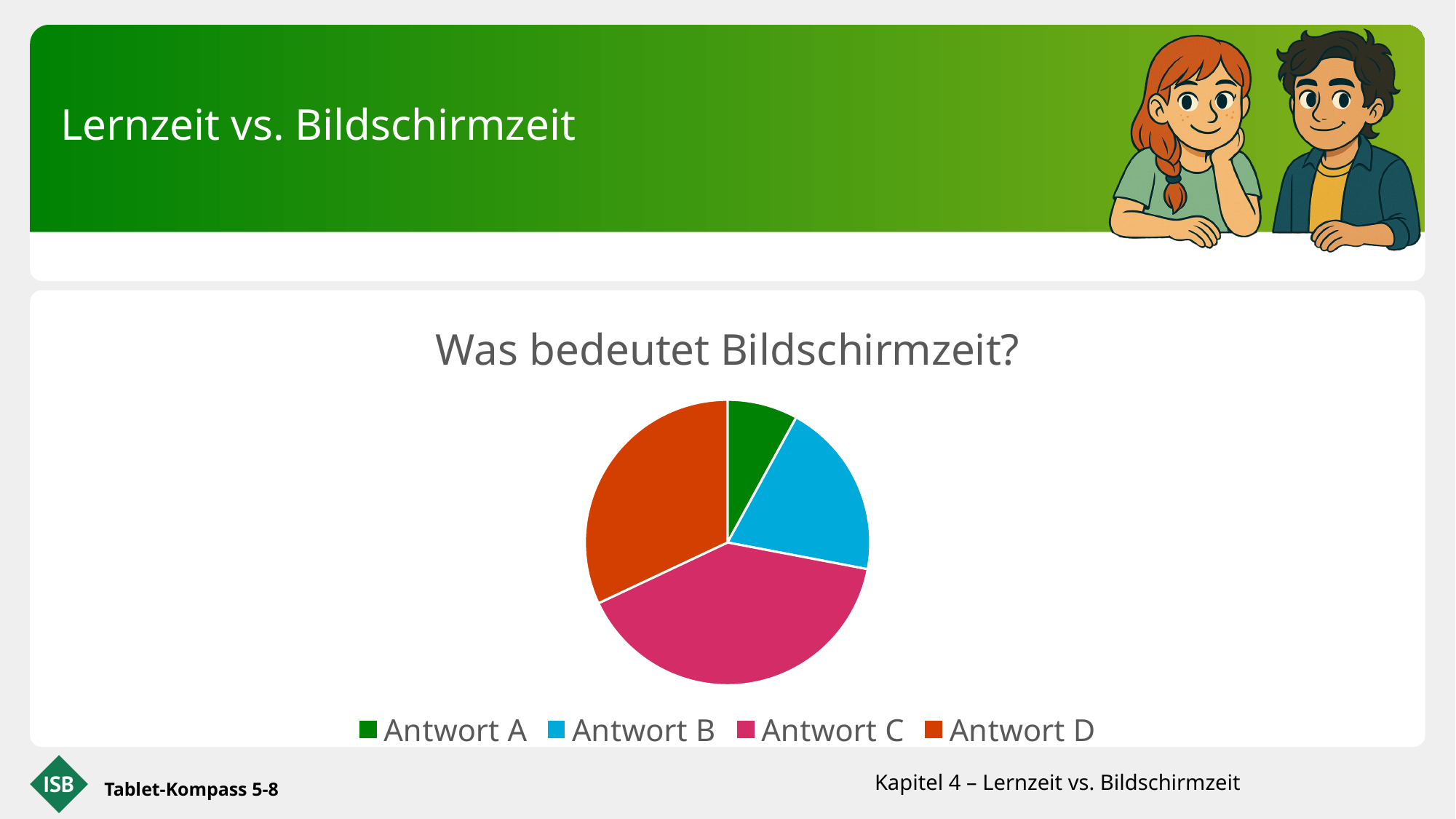
How many entries does the legend list? 4 Which slice is larger, Antwort A or Antwort D? Antwort D Which slice is larger, Antwort C or Antwort D? Antwort C Which slice is larger, Antwort B or Antwort D? Antwort D Which answer has the smallest slice of the pie? Antwort A What kind of chart is shown on the slide? Pie chart How many slices does the pie chart have? 4 What is the title of the chart? Was bedeutet Bildschirmzeit? Which colour represents Antwort C in the pie chart? Pink Which answer has the largest slice of the pie? Antwort C